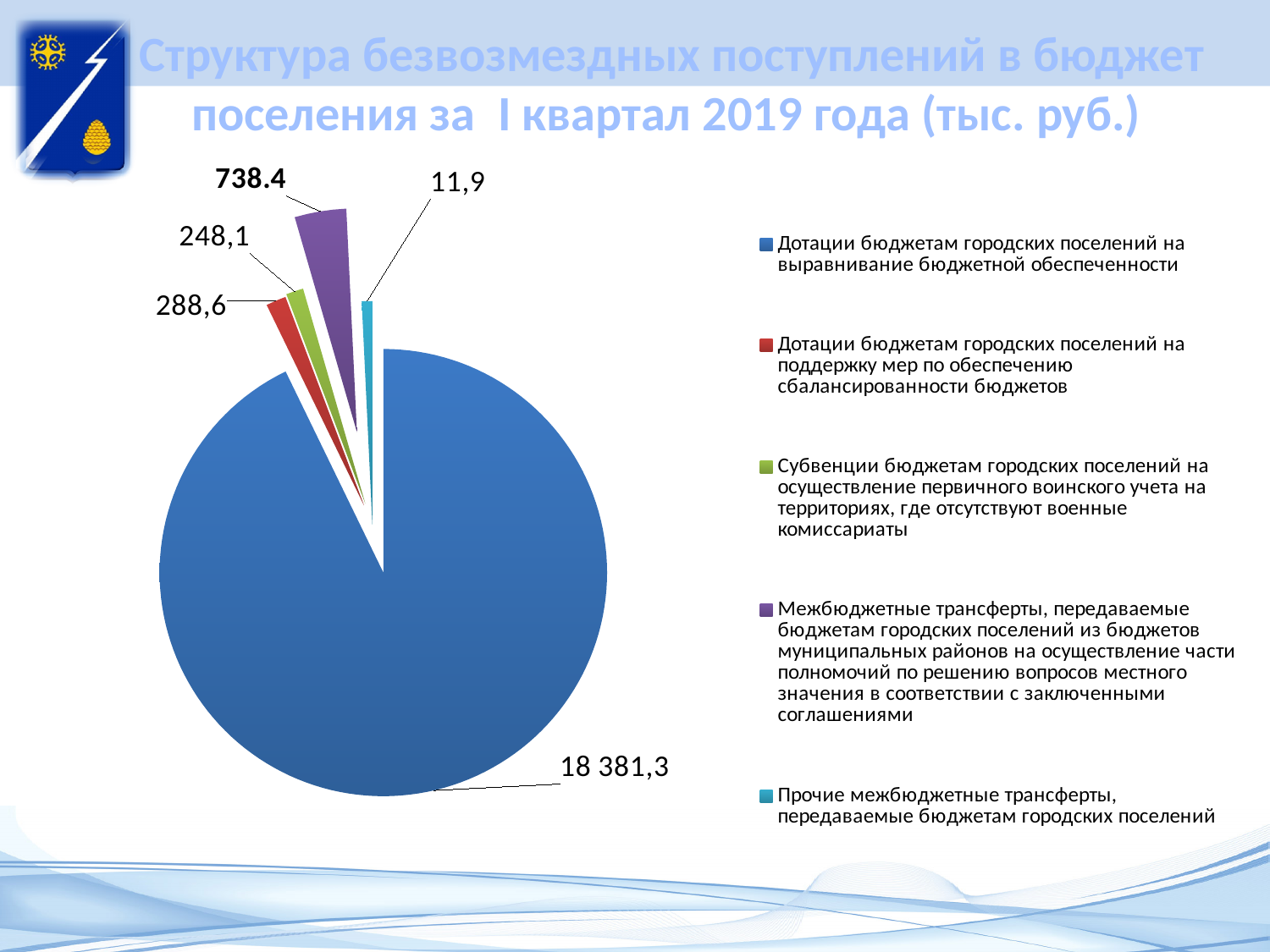
What is the value for 'Межбюджетные трансферты, передаваемые бюджетам городских поселений из бюджетов муниципальных районов...'? 738.4 Which is larger: the value for 'Дотации ... на поддержку мер по обеспечению сбалансированности бюджетов' or the value for 'Субвенции ... на осуществление первичного воинского учета'? Дотации ... на поддержку мер по обеспечению сбалансированности бюджетов How many slices does the pie chart have? 5 What is the value for 'Дотации бюджетам городских поселений на выравнивание бюджетной обеспеченности'? 18 381,3 Which category has the largest slice of the pie? Дотации бюджетам городских поселений на выравнивание бюджетной обеспеченности What type of chart is shown on the slide? pie chart What is the difference between the value for 'Межбюджетные трансферты, передаваемые бюджетам городских поселений из бюджетов муниципальных районов...' (738.4) and the value for 'Дотации ... на поддержку мер по обеспечению сбалансированности бюджетов' (288,6)? 449,8 Which category has the smallest slice of the pie? Прочие межбюджетные трансферты, передаваемые бюджетам городских поселений What is the value for 'Прочие межбюджетные трансферты, передаваемые бюджетам городских поселений'? 11,9 What is the total of all slices in the pie chart? 19 668,3 What colour is the slice for 'Прочие межбюджетные трансферты, передаваемые бюджетам городских поселений'? light blue (cyan) What is the value for 'Субвенции бюджетам городских поселений на осуществление первичного воинского учета...'? 248,1